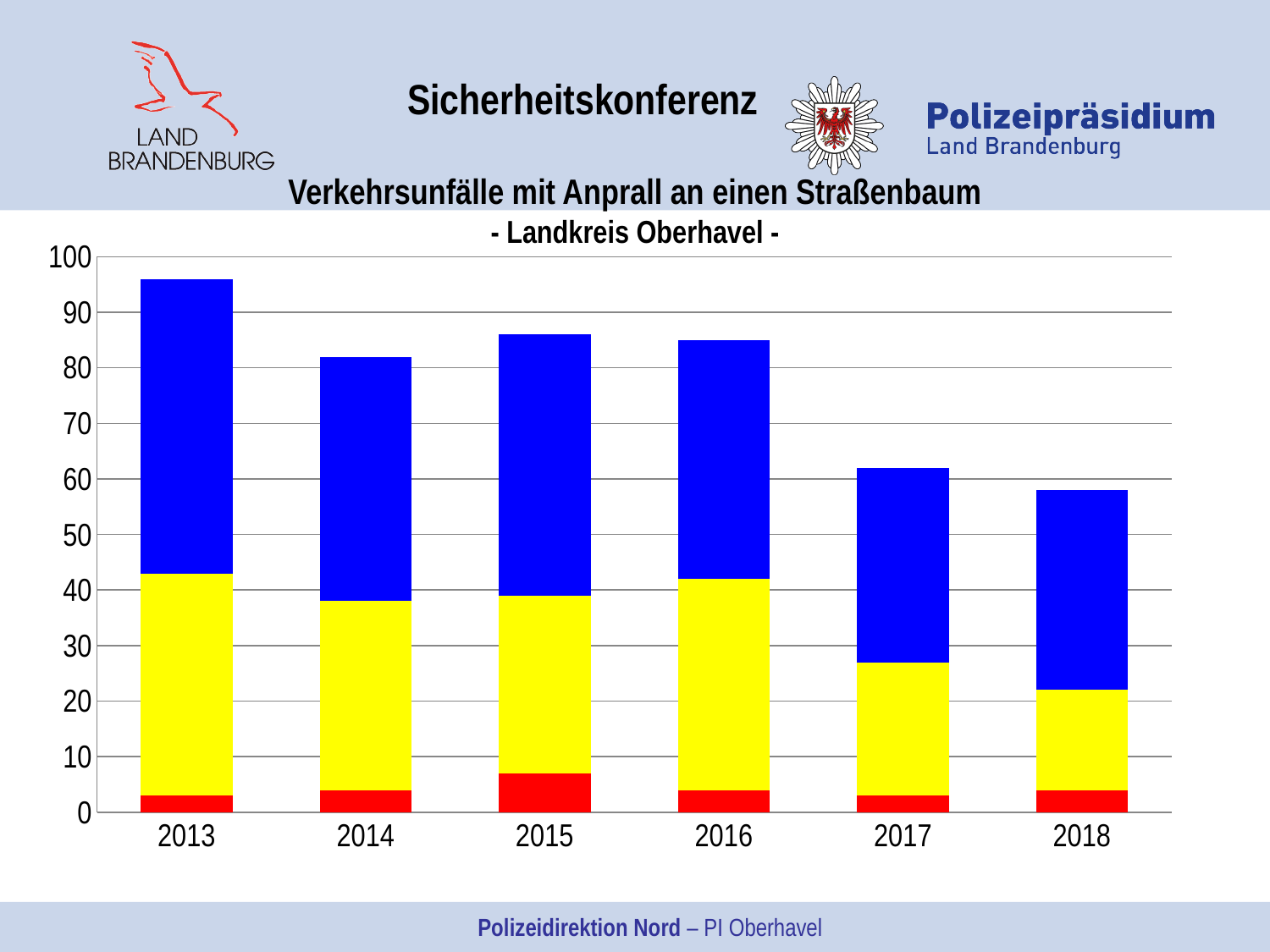
Which year has the shortest bar in the chart? 2018 Which year has the tallest bar in the chart? 2013 Is the total height of the bar for 2015 greater or less than 80? greater Is the total height of the bar for 2013 greater or less than 90? greater Is the total height of the bar for 2017 greater or less than 70? less Which bar is taller, 2013 or 2014? 2013 What is the title of the chart? Verkehrsunfälle mit Anprall an einen Straßenbaum - Landkreis Oberhavel - What kind of chart is shown on the slide? Stacked bar chart How many years are shown on the x axis of the chart? 6 Which bar is taller, 2016 or 2017? 2016 Do the bar totals overall rise or fall from 2013 to 2018? fall